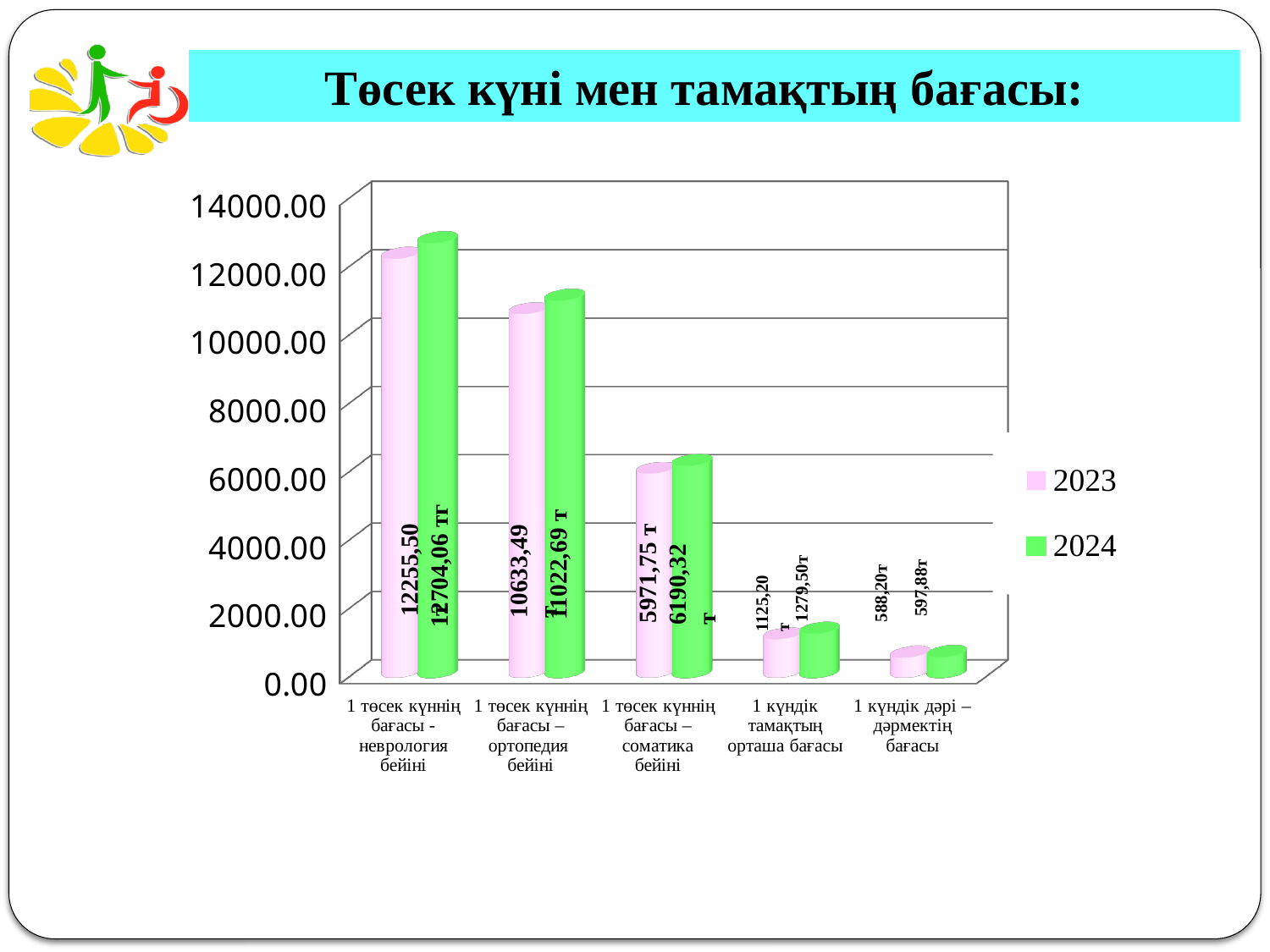
What is the difference between the 2024 and 2023 values for '1 төсек күннің бағасы – ортопедия бейіні'? 389,20 What is the 2024 value for '1 төсек күннің бағасы - неврология бейіні'? 12704,06 тг How many categories are shown on the x axis? 5 What is the 2023 value for '1 күндік тамақтың орташа бағасы'? 1125,20 т What is the 2024 value for '1 күндік дәрі – дәрмектің бағасы'? 597,88т What is the 2024 value for '1 төсек күннің бағасы – соматика бейіні'? 6190,32 т What is the 2023 value for '1 төсек күннің бағасы – ортопедия бейіні'? 10633,49 т Which category has the highest 2024 value? 1 төсек күннің бағасы - неврология бейіні Which category has the lowest 2023 value? 1 күндік дәрі – дәрмектің бағасы What type of chart is shown on the slide? Bar chart Which is larger for '1 күндік тамақтың орташа бағасы': the 2023 value or the 2024 value? 2024 How many series does the legend list? 2